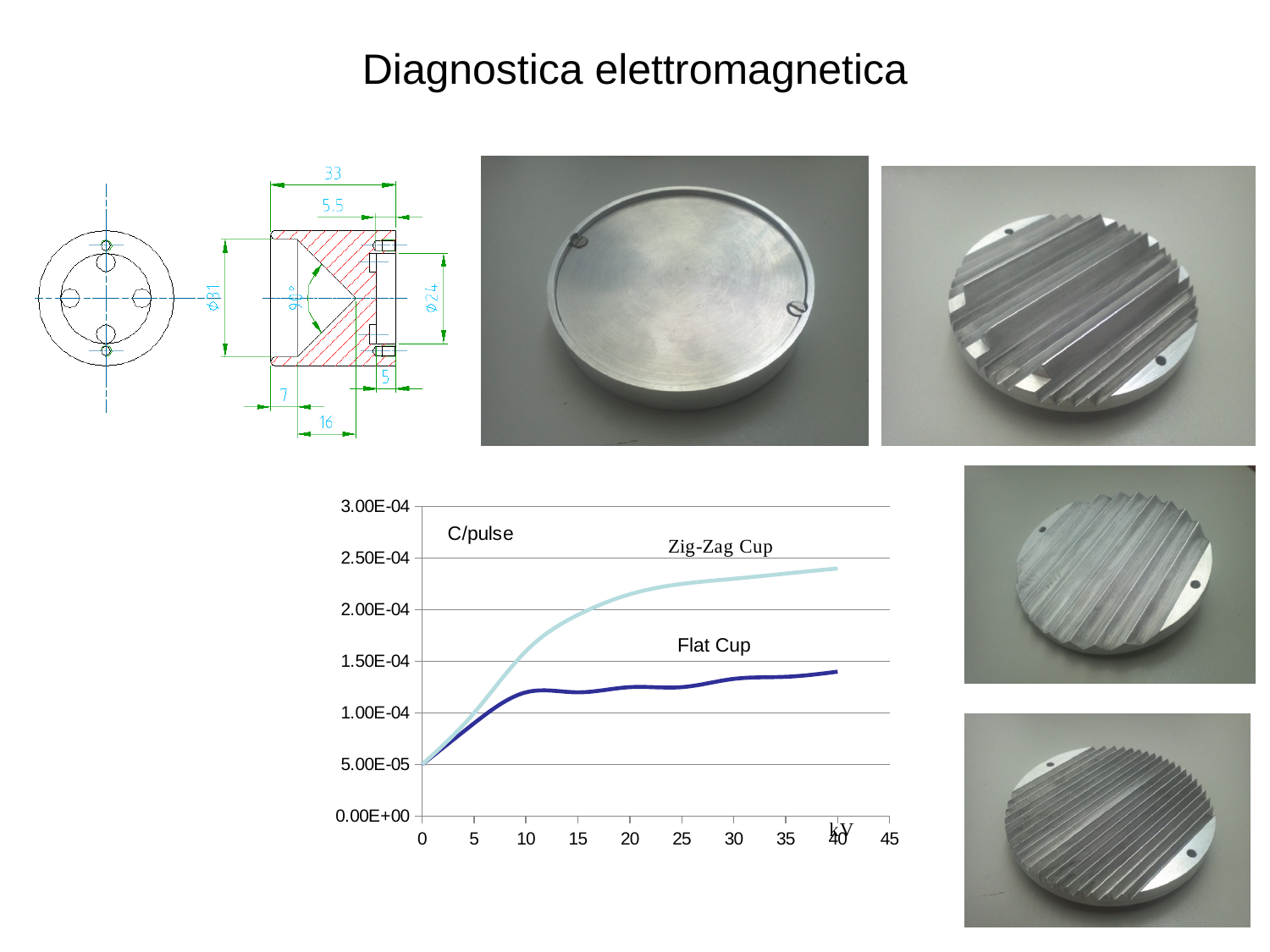
Which series reaches the higher value at 40 kV, Zig-Zag Cup or Flat Cup? Zig-Zag Cup What is the unit shown on the vertical axis of the chart? C/pulse What is the highest value shown on the vertical axis of the chart? 3.00E-04 Is the value for Flat Cup at 40 kV greater or less than 1.50E-04? less What is the unit shown on the horizontal axis of the chart? kV Is the value for Flat Cup at 20 kV greater or less than 1.00E-04? greater What kind of chart is shown on the slide? line chart Is the value for Zig-Zag Cup at 20 kV greater or less than 2.00E-04? greater Do the values for Zig-Zag Cup rise or fall as kV increases? rise Which series has the lowest values across the plotted range? Flat Cup How many series are plotted in the chart? 2